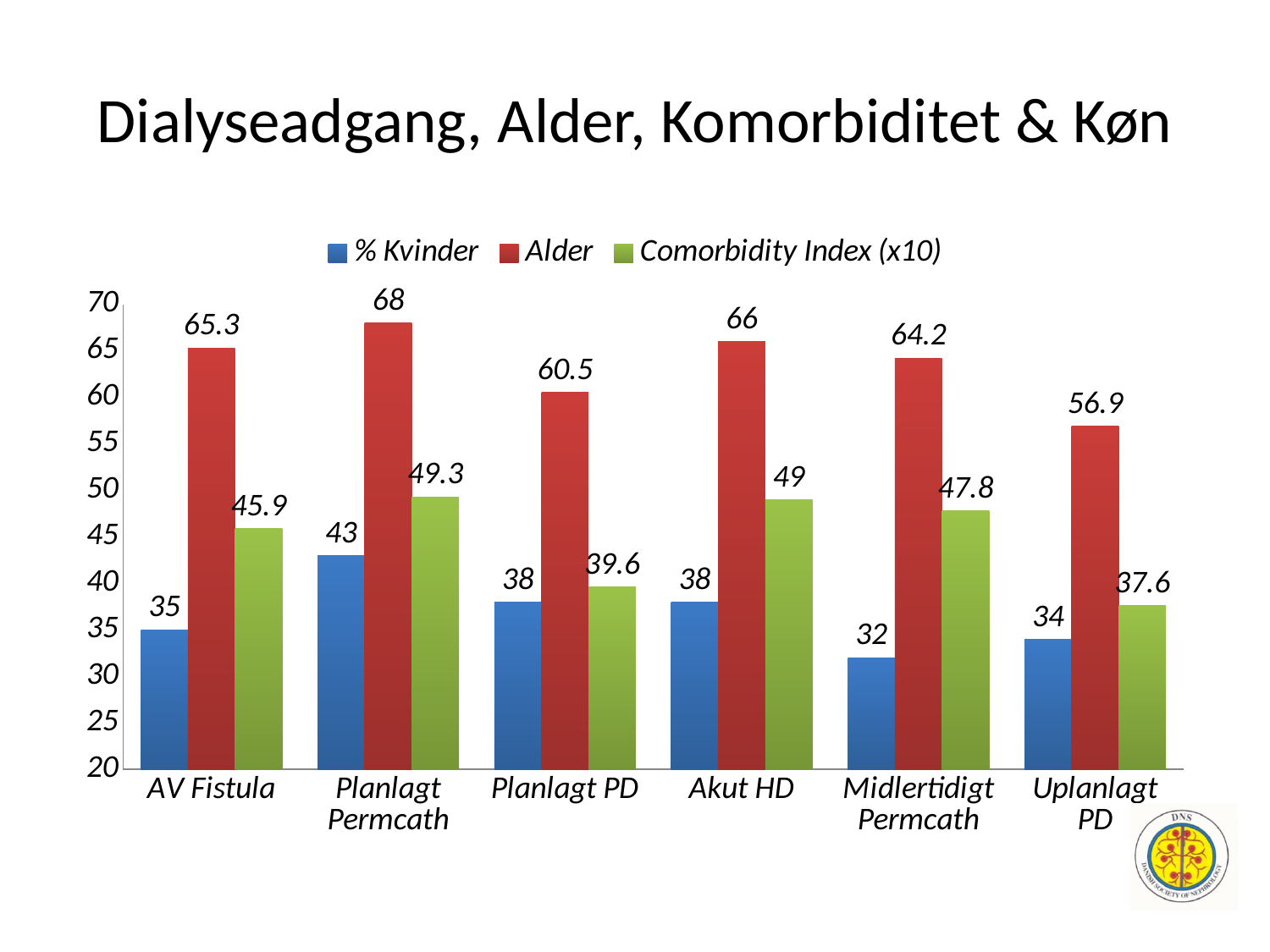
Which category has the lowest % Kvinder value? Midlertidigt Permcath How many series does the legend list? 3 Which colour represents the Alder series? Red What is the title of the slide? Dialyseadgang, Alder, Komorbiditet & Køn Which category has the highest Alder value? Planlagt Permcath What kind of chart is shown on the slide? Bar chart Which is larger, the Comorbidity Index (x10) for Planlagt PD or for Akut HD? Akut HD What is the difference between the Alder values for AV Fistula and Uplanlagt PD? 8.4 What is the % Kvinder value for Midlertidigt Permcath? 32 What is the Alder value for Planlagt Permcath? 68 How many categories are shown on the x axis? 6 What is the Comorbidity Index (x10) value for Uplanlagt PD? 37.6